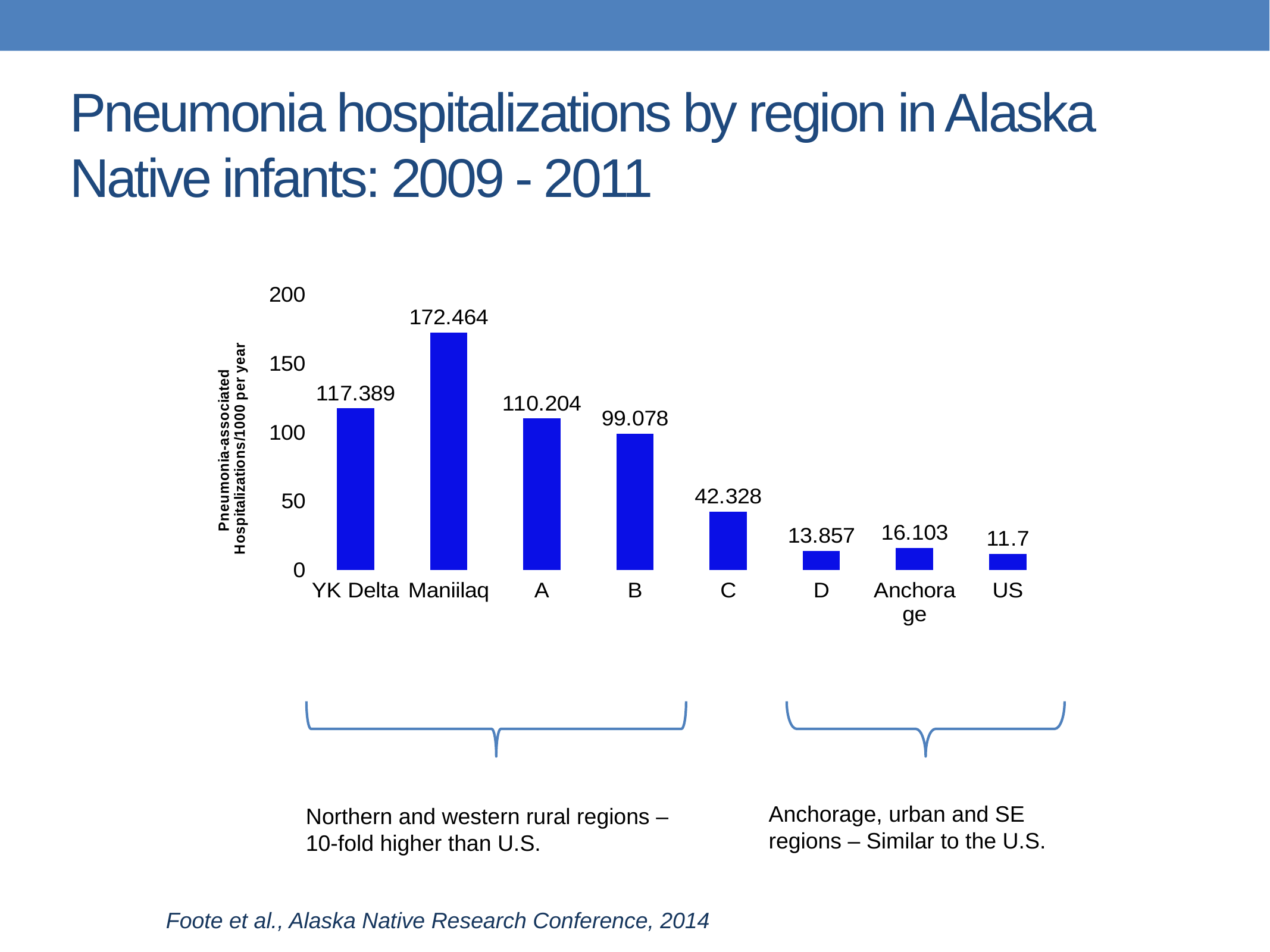
What is the value for Maniilaq? 172.464 Which region has the highest value? Maniilaq What kind of chart is shown on the slide? bar chart How many categories are shown on the x axis? 8 What is the value for Anchorage? 16.103 Which is larger, the value for A or the value for B? A What is the value for US? 11.7 Is the value for C greater or less than 50? less What is the value for YK Delta? 117.389 Which category has the lowest value? US What is the difference between the values for Maniilaq and YK Delta? 55.075 What is the label of the y axis? Pneumonia-associated Hospitalizations/1000 per year